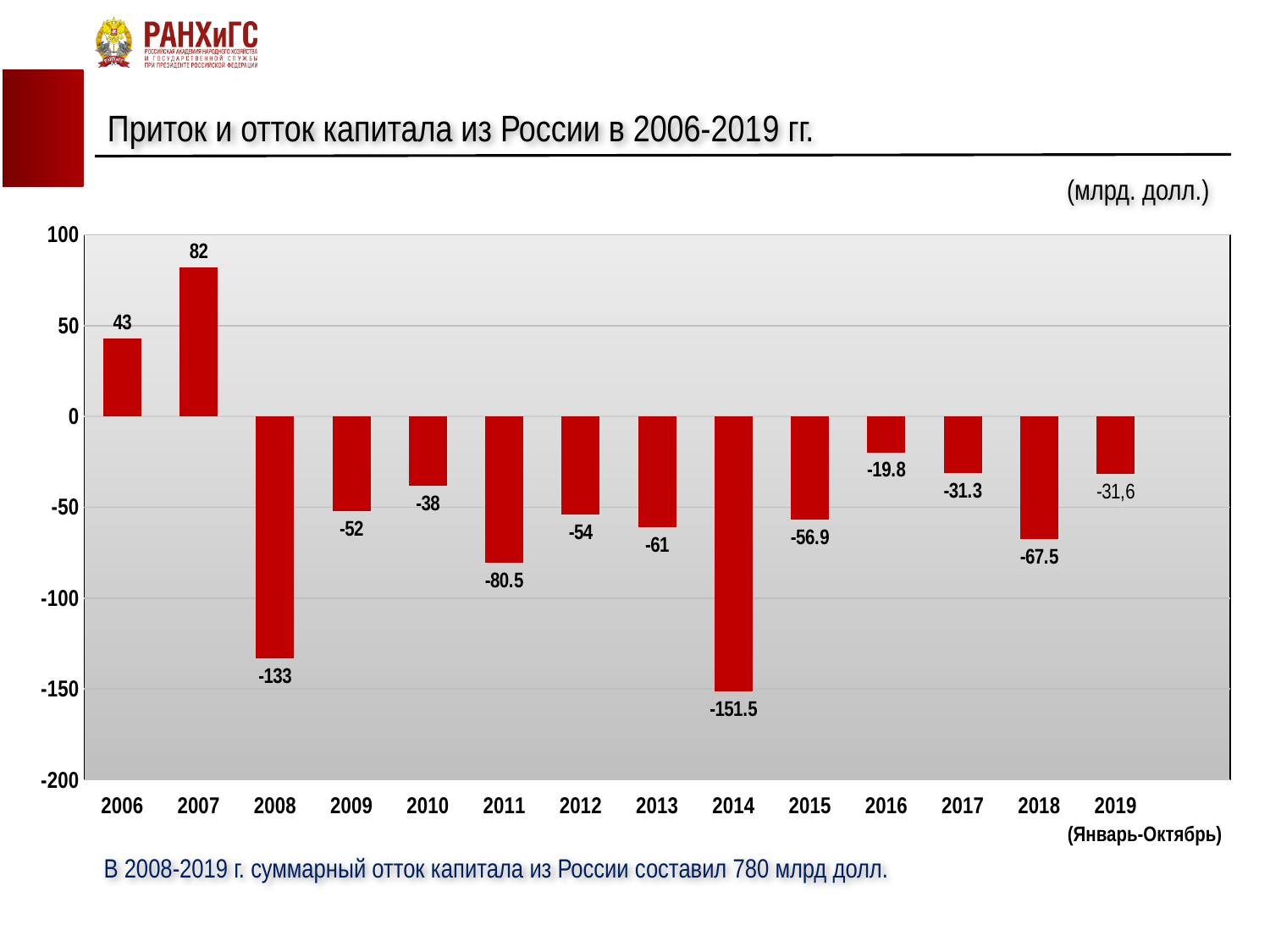
What is the value for 2019 (Январь-Октябрь)? -31,6 What is the value for 2014? -151.5 What kind of chart is this? bar chart What is the value for 2018? -67.5 How many years are shown on the x axis? 14 What is the difference between the values for 2007 and 2006? 39 Which year has the highest value? 2007 What is the title of the chart? Приток и отток капитала из России в 2006-2019 гг. What is the value for 2007? 82 Which year has the lowest value? 2014 What unit is given for the values on the chart? млрд. долл. Which is larger, the value for 2009 or the value for 2010? 2010